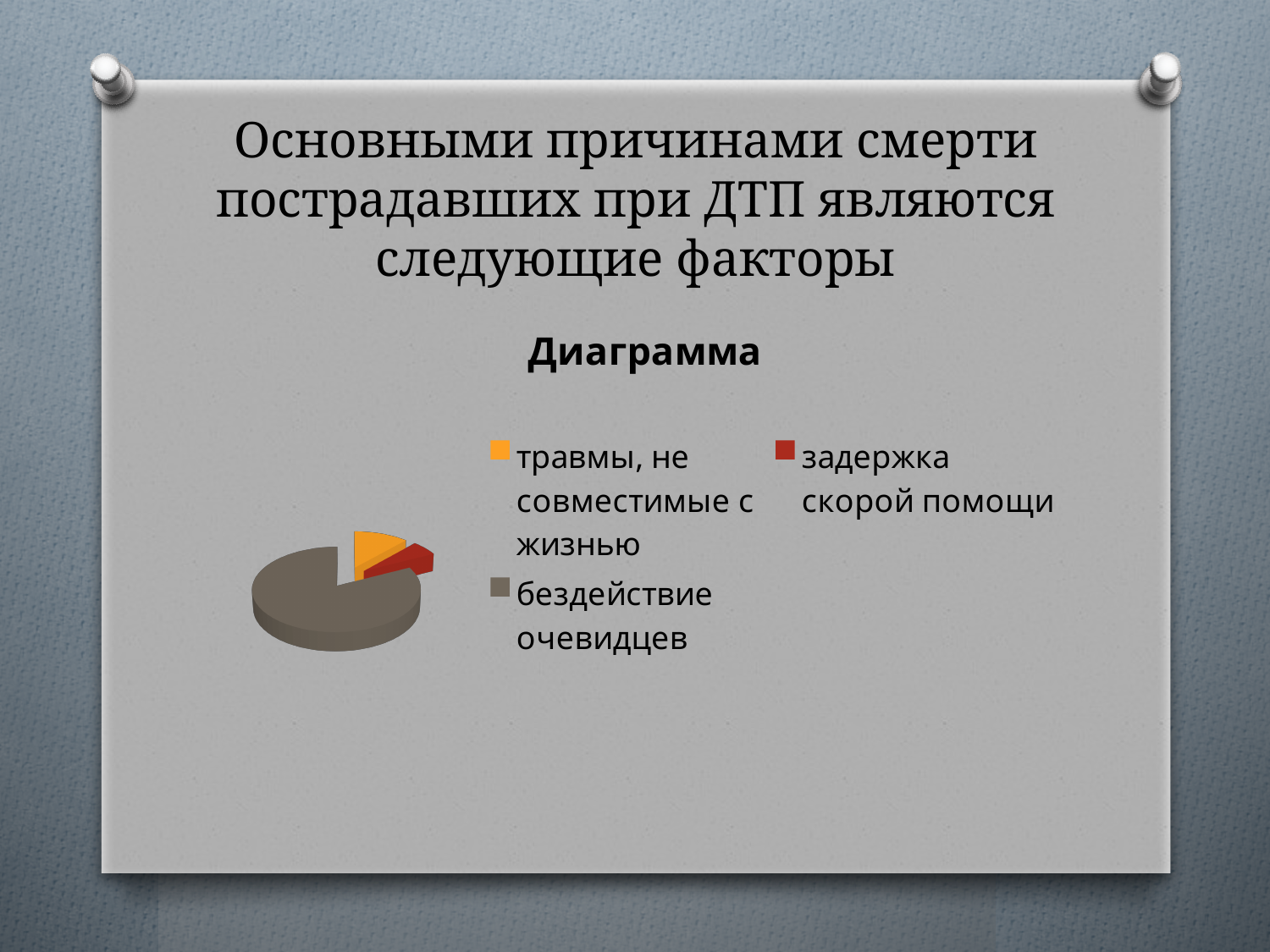
What colour is the slice for задержка скорой помощи? red Which is larger: the slice for травмы, не совместимые с жизнью or the slice for бездействие очевидцев? бездействие очевидцев How many slices does the pie chart have? 3 What kind of chart is shown on the slide? pie chart How many entries does the chart legend list? 3 Which category has the largest slice of the pie? бездействие очевидцев Which is larger: the slice for бездействие очевидцев or the slice for задержка скорой помощи? бездействие очевидцев What is the title of the chart? Диаграмма